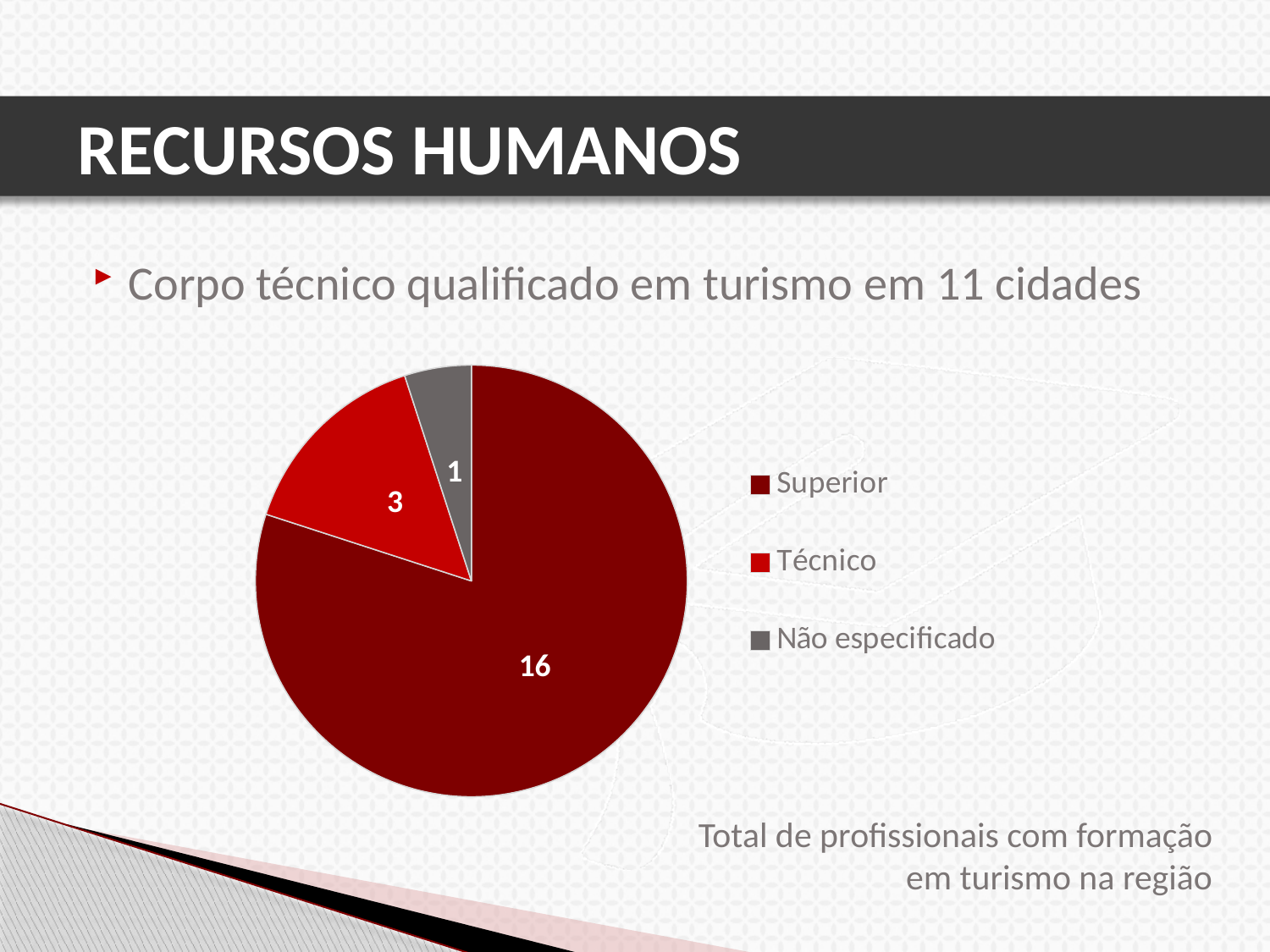
What is the value for Técnico in the pie chart? 3 What kind of chart is shown on the slide? pie chart What is the total of all slices in the pie chart? 20 What is the value for Superior in the pie chart? 16 What is the value for Não especificado in the pie chart? 1 What share of the pie does the Superior slice represent? 80% What colour is the Não especificado slice in the pie chart? grey Which is larger, the value for Técnico or the value for Não especificado? Técnico Which category has the smallest slice in the pie chart? Não especificado What is the difference between the values for Superior and Técnico? 13 Which category has the largest slice in the pie chart? Superior How many categories does the pie chart have? 3